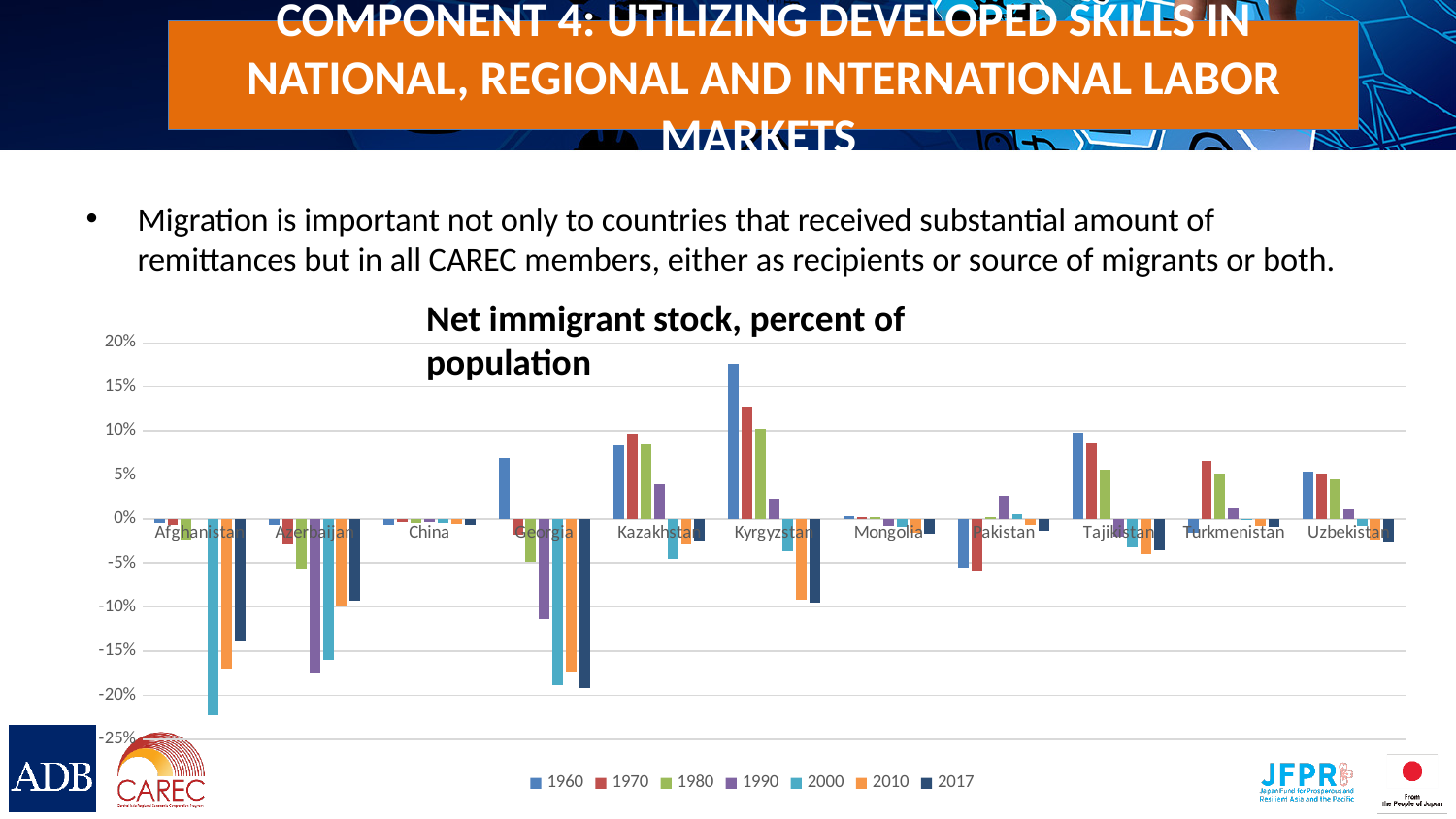
Is the 1990 value for Azerbaijan greater or less than -15%? less How many countries are shown on the x axis of the chart? 11 Which is larger, the 1960 value for Kyrgyzstan or the 1960 value for Kazakhstan? Kyrgyzstan Is the 1970 value for Kyrgyzstan greater or less than 10%? greater Which country has the highest bar in the chart? Kyrgyzstan Which country has the lowest bar in the chart? Afghanistan Is the 1960 value for Kyrgyzstan greater or less than 15%? greater What kind of chart is shown on the slide? bar chart What is the title of the chart? Net immigrant stock, percent of population Which year does the dark navy series in the legend represent? 2017 How many series does the chart legend list? 7